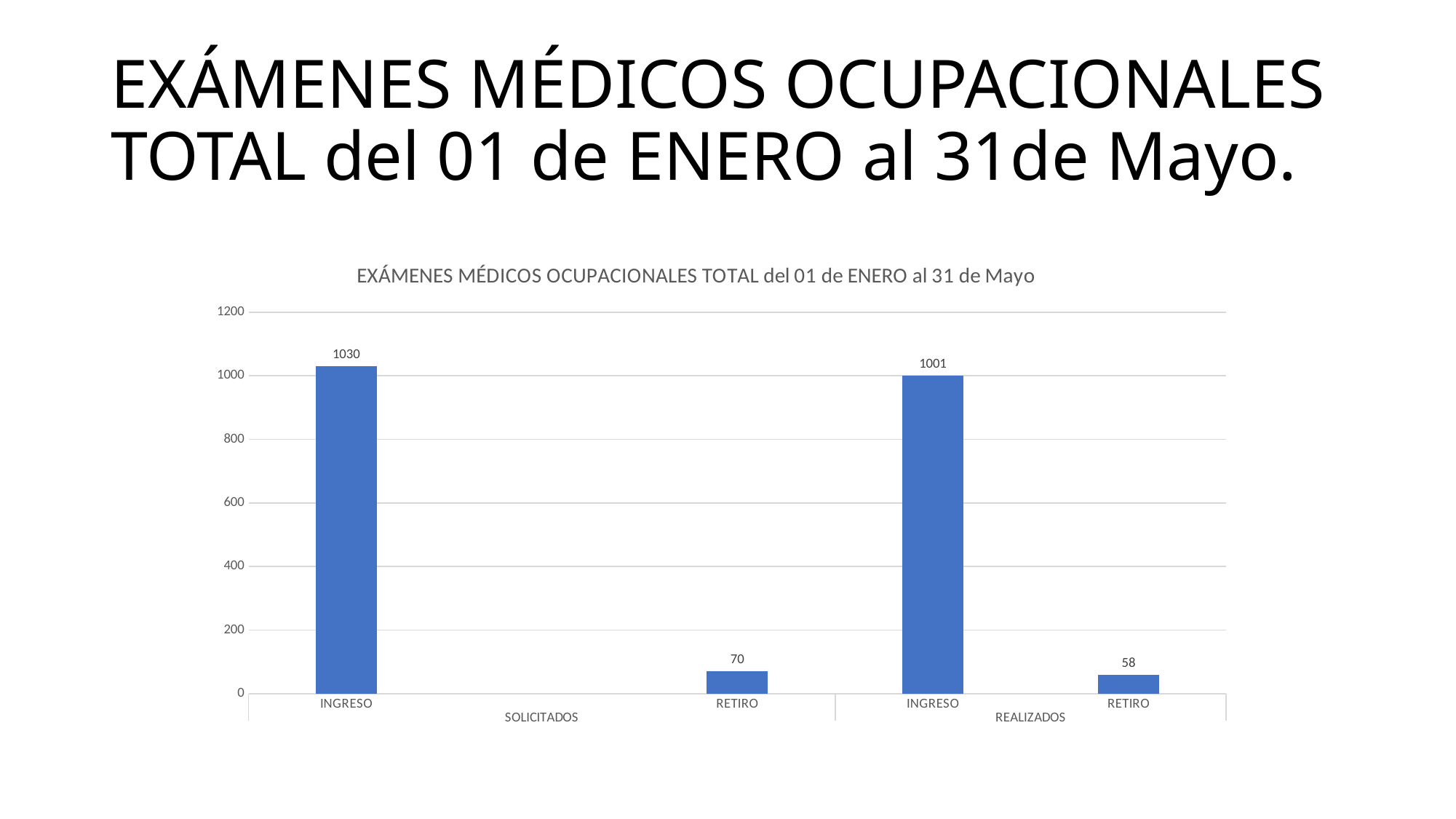
What is the value for INGRESO under SOLICITADOS? 1030 How many bars are plotted in the chart? 4 What is the value for INGRESO under REALIZADOS? 1001 What is the value for RETIRO under REALIZADOS? 58 Which is larger, RETIRO under SOLICITADOS or RETIRO under REALIZADOS? RETIRO under SOLICITADOS Which bar has the lowest value? RETIRO (REALIZADOS) What is the difference between INGRESO SOLICITADOS and INGRESO REALIZADOS? 29 What is the difference between RETIRO SOLICITADOS and RETIRO REALIZADOS? 12 Is the value for INGRESO under REALIZADOS greater or less than 800? greater What kind of chart is shown on the slide? Bar chart Which bar has the highest value? INGRESO (SOLICITADOS) What is the value for RETIRO under SOLICITADOS? 70